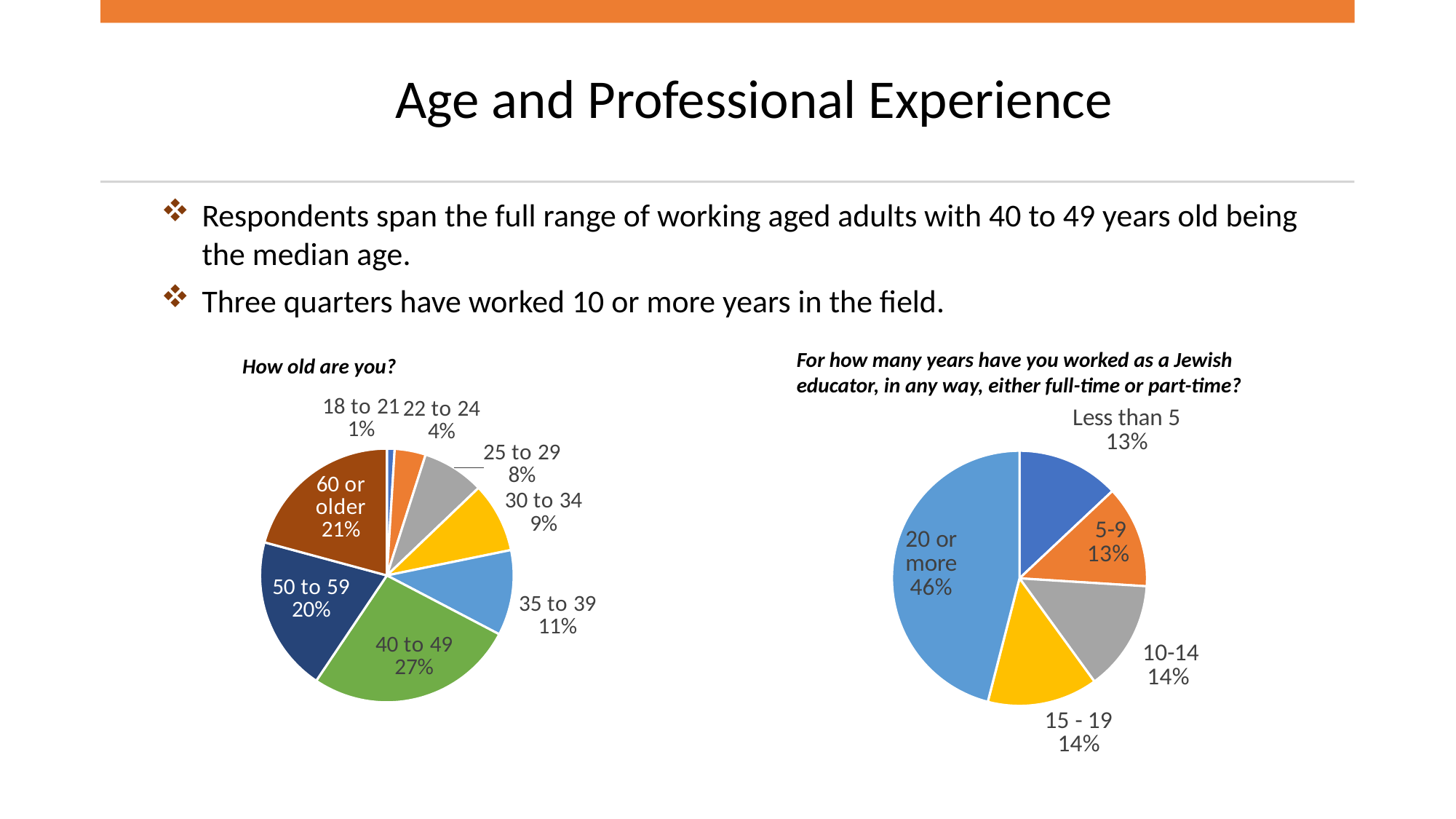
In the "How old are you?" pie chart, how many age groups are shown? 8 In the years-worked pie chart on the right, which category has the largest share? 20 or more In the "How old are you?" pie chart, which is larger: the share for 30 to 34 or the share for 25 to 29? 30 to 34 In the "How old are you?" pie chart, what share of respondents are 40 to 49? 27% What type of chart is used for the "How old are you?" data? Pie chart In the years-worked pie chart on the right, what share of respondents have worked 10-14 years? 14% In the years-worked pie chart on the right, how many categories are shown? 5 In the "How old are you?" pie chart, which age group has the smallest share? 18 to 21 In the "How old are you?" pie chart, what share of respondents are 60 or older? 21% In the "How old are you?" pie chart, which age group has the largest share? 40 to 49 In the "How old are you?" pie chart, what is the difference in percentage points between the 50 to 59 and 35 to 39 groups? 9 In the years-worked pie chart on the right, what share of respondents have worked 20 or more years? 46%